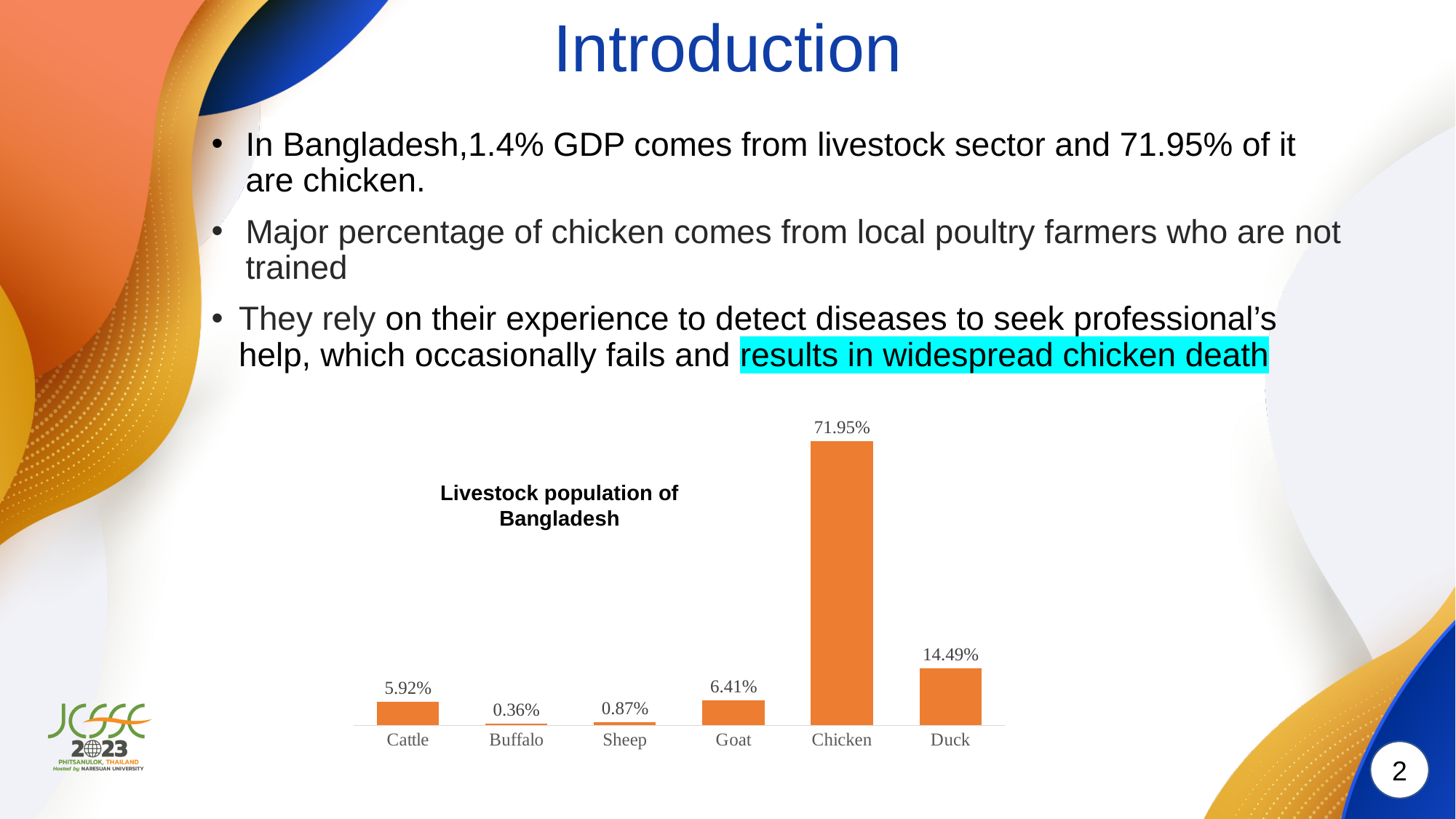
Which category has the lowest value in the Livestock population of Bangladesh chart? Buffalo What is the title of the chart on the slide? Livestock population of Bangladesh What is the value for Goat in the Livestock population of Bangladesh chart? 6.41% What is the difference between the values for Chicken and Duck in the Livestock population of Bangladesh chart? 57.46% Which is larger in the Livestock population of Bangladesh chart, the value for Sheep or the value for Buffalo? Sheep Which category has the highest value in the Livestock population of Bangladesh chart? Chicken What kind of chart is the Livestock population of Bangladesh chart? Bar chart What is the value for Chicken in the Livestock population of Bangladesh chart? 71.95% What is the difference between the values for Goat and Cattle in the Livestock population of Bangladesh chart? 0.49% What is the value for Duck in the Livestock population of Bangladesh chart? 14.49% What is the value for Buffalo in the Livestock population of Bangladesh chart? 0.36% How many categories are shown in the Livestock population of Bangladesh chart? 6